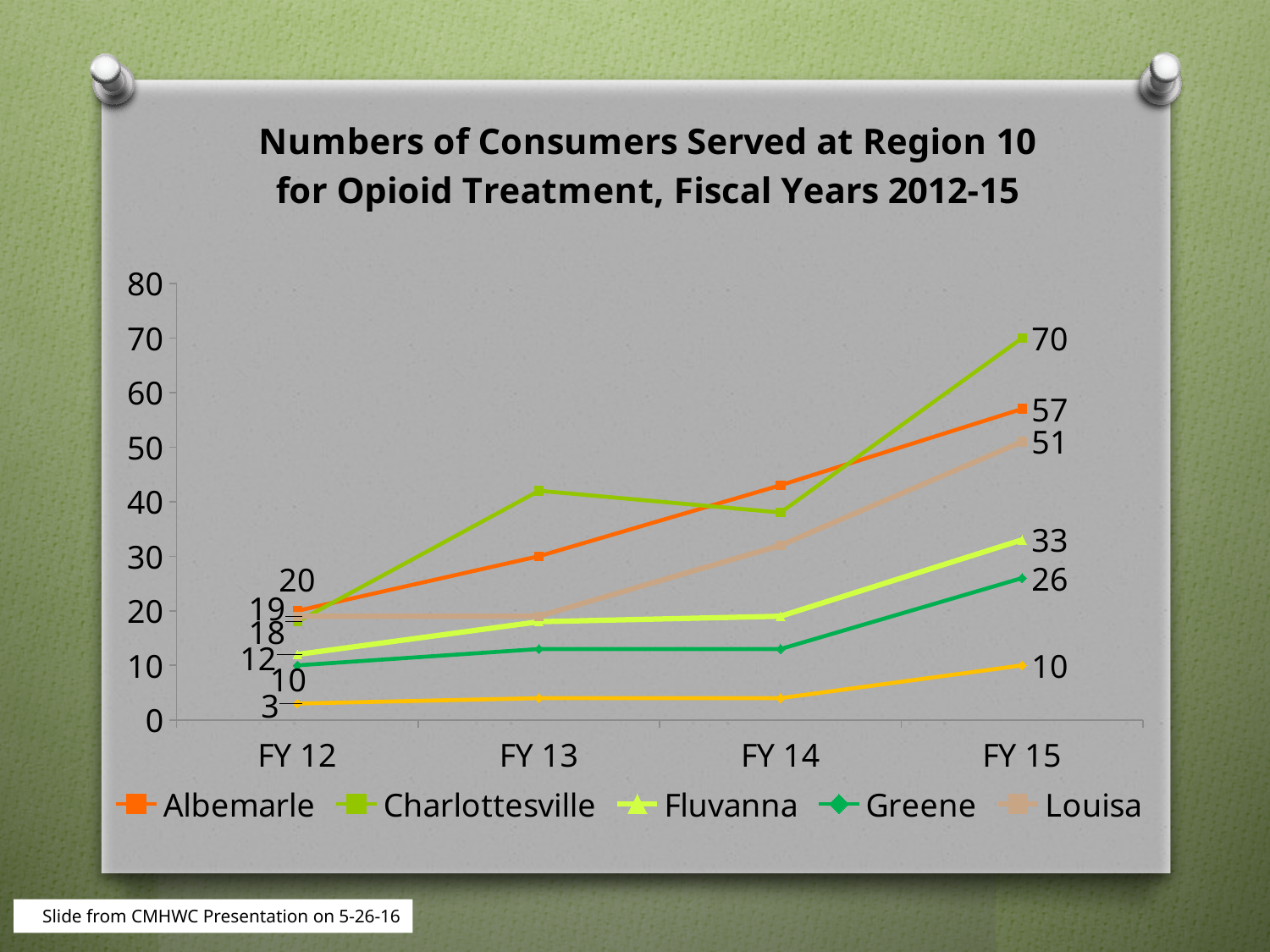
In FY 15, which is larger, the value for Louisa or the value for Fluvanna? Louisa How many series does the legend list? 5 Is the value for Albemarle in FY 13 greater or less than 40? less What is the difference between the Charlottesville and Albemarle values in FY 15? 13 What is the value for Fluvanna in FY 15? 33 How many fiscal years are shown on the x axis? 4 Which locality had the highest number of consumers served in FY 15? Charlottesville What is the value for Louisa in FY 15? 51 What kind of chart is shown on the slide? line chart What is the value for Charlottesville in FY 15? 70 What is the value for Greene in FY 15? 26 What is the value for Albemarle in FY 15? 57